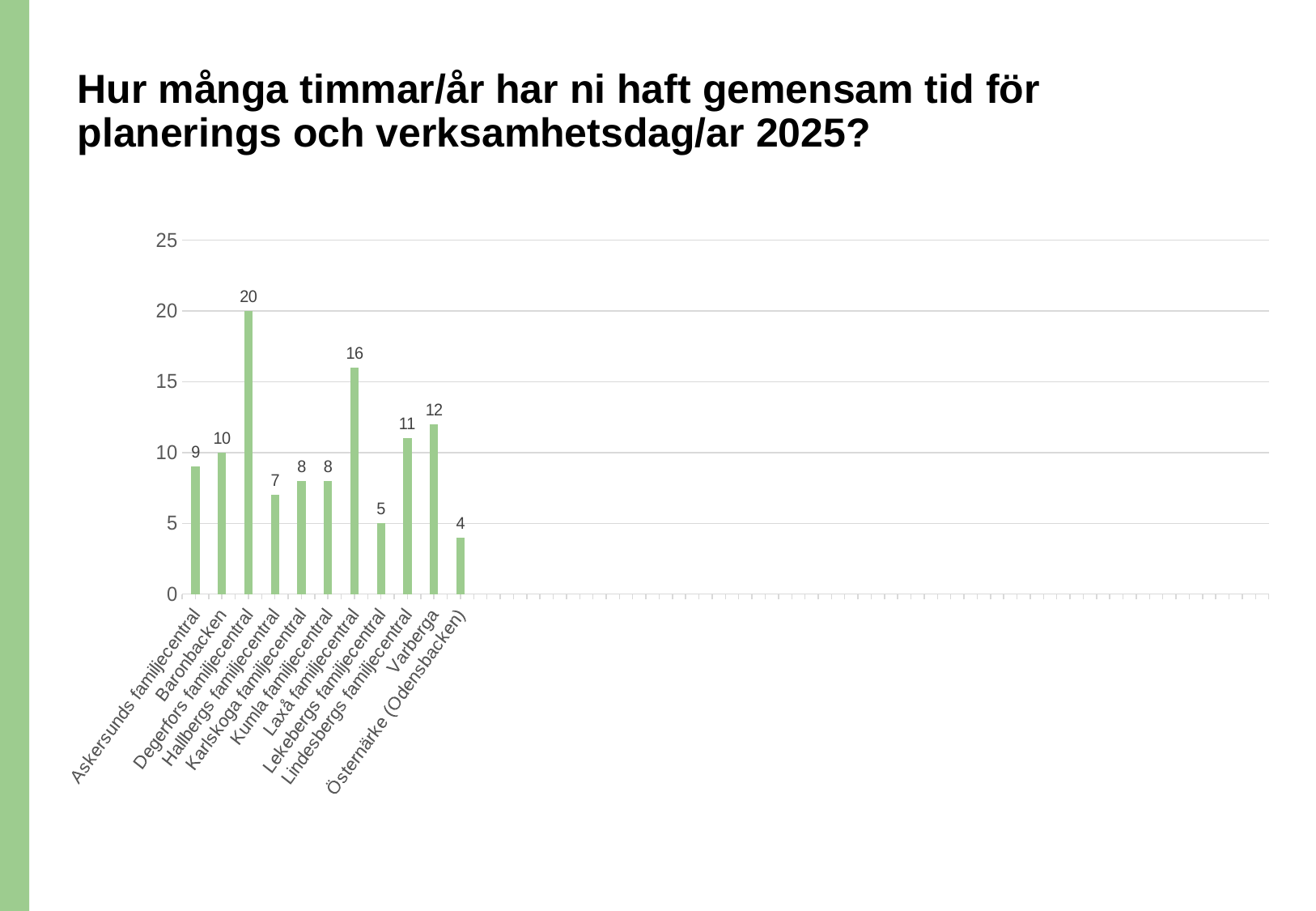
What is the value for Laxå familjecentral? 16 What is the value for Varberga? 12 What is the value for Degerfors familjecentral? 20 How many categories are shown on the x axis? 11 Which category has the highest value? Degerfors familjecentral What is the title of the slide? Hur många timmar/år har ni haft gemensam tid för planerings och verksamhetsdag/ar 2025? Which is larger, the value for Lindesbergs familjecentral or the value for Baronbacken? Lindesbergs familjecentral Is the value for Lekebergs familjecentral greater or less than 10? less What kind of chart is shown on the slide? bar chart Which category has the lowest value? Östernärke (Odensbacken) What is the difference between the values for Degerfors familjecentral and Laxå familjecentral? 4 What is the value for Östernärke (Odensbacken)? 4